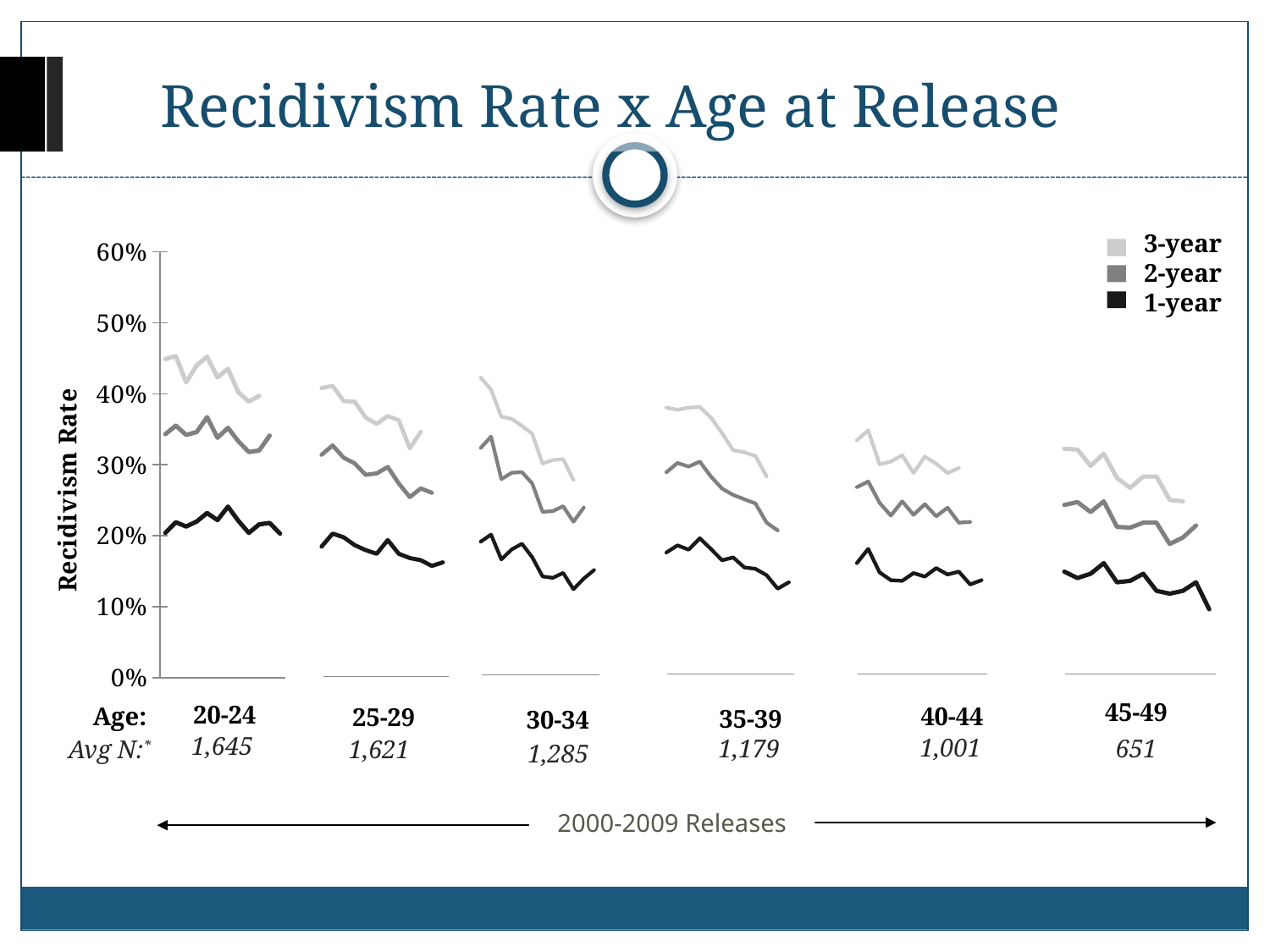
Are the 1-year recidivism rate values for the 45-49 age group greater or less than 20%? less Which series is drawn in black according to the legend? 1-year What is the title of the chart? Recidivism Rate x Age at Release What is the Avg N for the 30-34 age group? 1,285 How many age groups are plotted along the x axis? 6 What is the difference between the Avg N for the 20-24 group and the 45-49 group? 994 What is the Avg N for the 45-49 age group? 651 What kind of chart is shown on the slide? line chart Which age group has the highest Avg N? 20-24 How many series does the legend list? 3 Within each age group, do the recidivism rates generally rise or fall across the 2000-2009 releases? fall Which age group has the lowest Avg N? 45-49